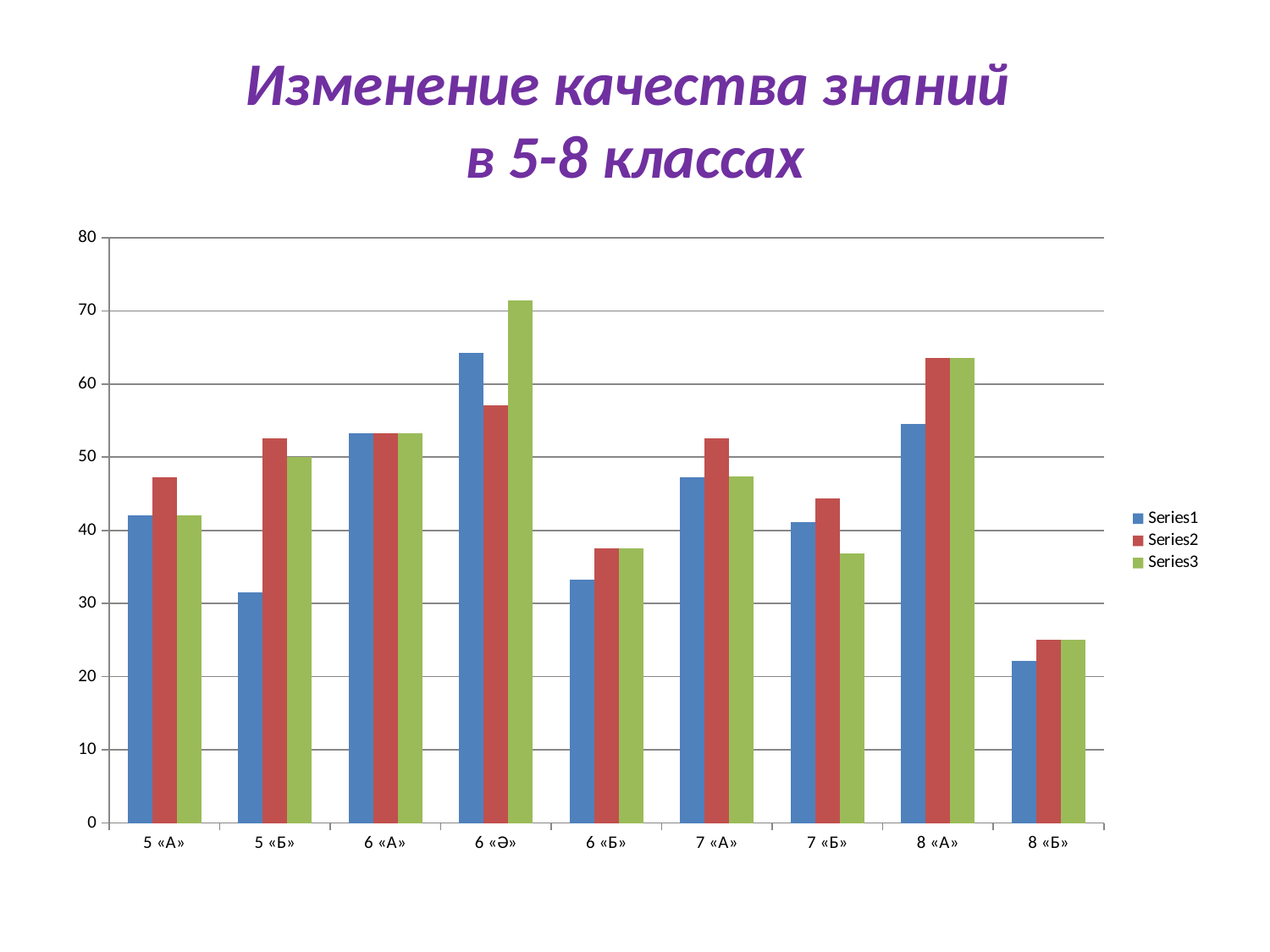
How many classes (categories) are shown on the x axis? 9 Which class has the lowest Series1 value? 8 «Б» What kind of chart is shown on the slide? bar chart Is the Series2 value for 8 «А» greater or less than 60? greater What is the title of the chart on the slide? Изменение качества знаний в 5-8 классах Is the Series1 value for 5 «Б» greater or less than 40? less Which class has the highest Series2 value? 8 «А» Which class has the highest Series3 value? 6 «Ә» For 7 «Б», which is larger: Series2 or Series3? Series2 How many series does the legend list? 3 Is the Series3 value for 6 «Э» greater or less than 60? greater For 5 «Б», which is larger: Series1 or Series2? Series2